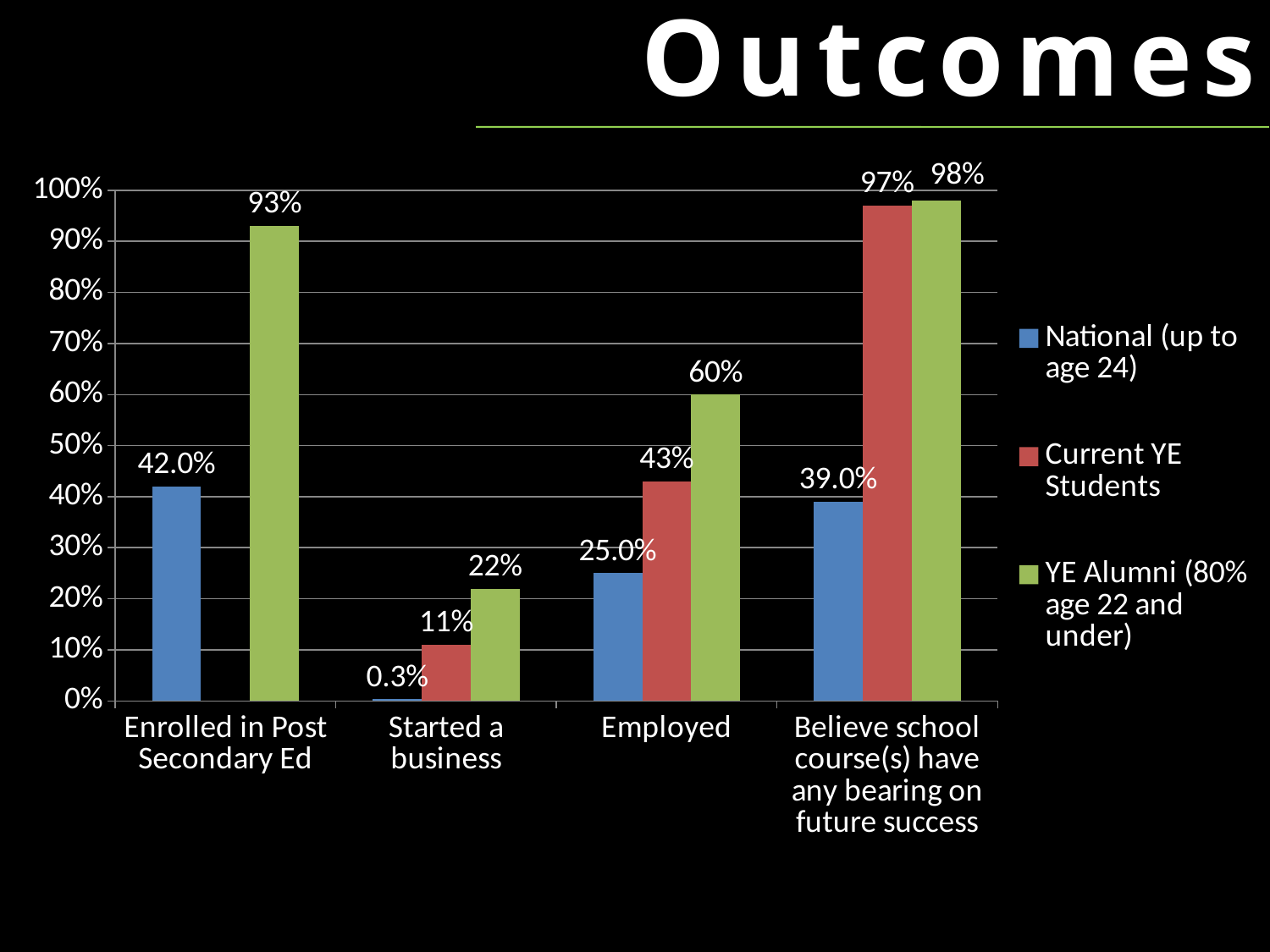
What is the title of the slide? Outcomes What is the value for Current YE Students in the Started a business category? 11% What kind of chart is shown on the slide? Bar chart What is the difference between the YE Alumni and National values in the Employed category? 35% Which category has the lowest value for National (up to age 24)? Started a business How many categories are shown on the x axis? 4 What is the value for National (up to age 24) in the Believe school course(s) have any bearing on future success category? 39.0% What is the value for YE Alumni (80% age 22 and under) in the Enrolled in Post Secondary Ed category? 93% What is the value for National (up to age 24) in the Employed category? 25.0% Which category has the highest value for YE Alumni (80% age 22 and under)? Believe school course(s) have any bearing on future success How many series does the legend list? 3 In the Started a business category, which is larger: the Current YE Students value or the YE Alumni value? YE Alumni